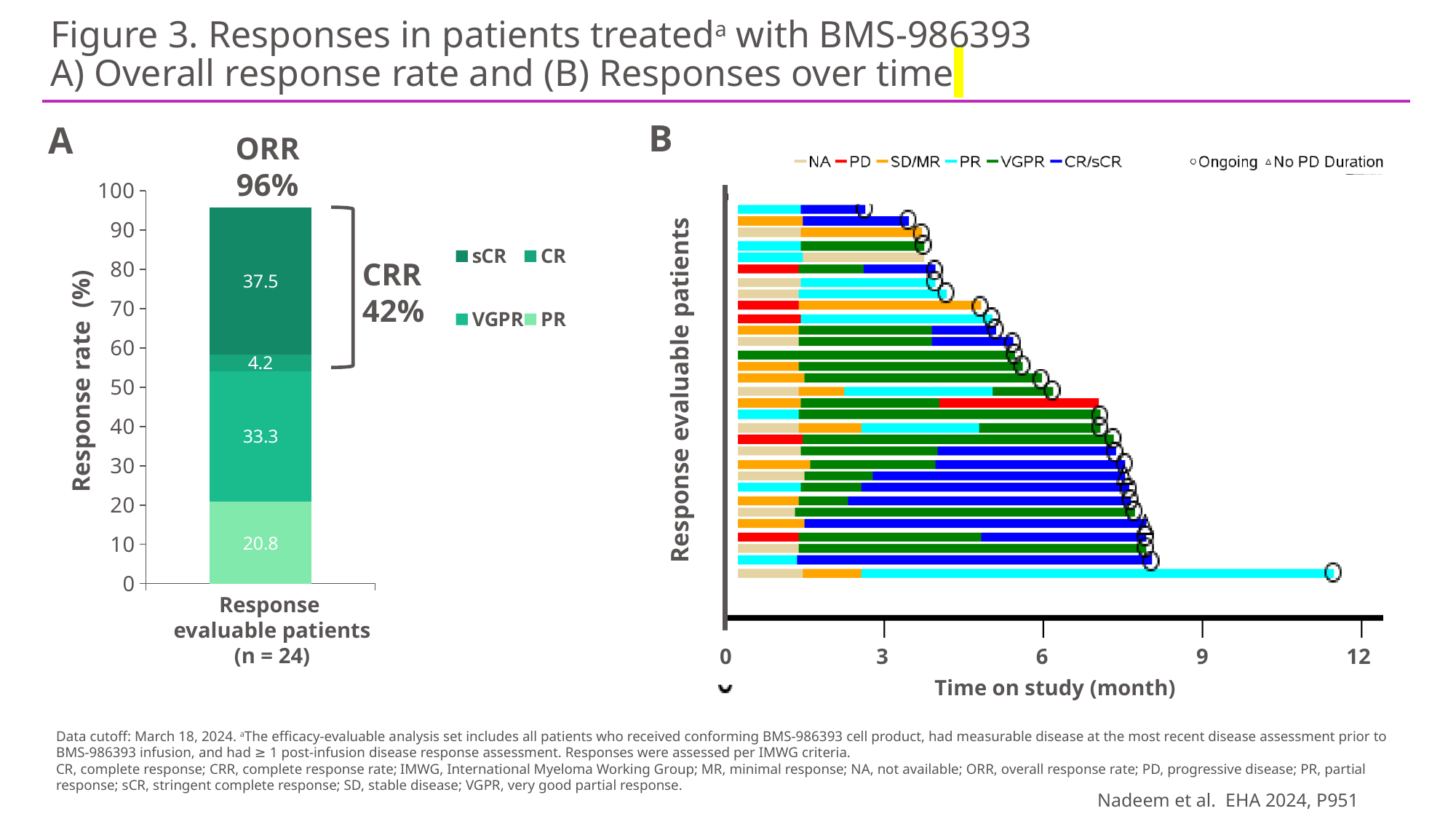
What kind of chart is chart A (Overall response rate)? Stacked bar chart In chart B (Responses over time), how many response categories (NA through CR/sCR) does the legend list? 6 In chart A (Overall response rate), how many response categories does the legend list? 4 In chart A (Overall response rate), what is the difference between the sCR value and the VGPR value? 4.2 In chart B (Responses over time), is the longest patient bar greater or less than 9 months? greater In chart A (Overall response rate), what is the value shown for the PR segment? 20.8 In chart A (Overall response rate), what is the value shown for the sCR segment? 37.5 In chart A (Overall response rate), what ORR is shown above the bar? 96% In chart A (Overall response rate), what is the value shown for the CR segment? 4.2 In chart A (Overall response rate), what is the value shown for the VGPR segment? 33.3 In chart A (Overall response rate), which response category has the smallest segment? CR In chart A (Overall response rate), which response category has the largest segment? sCR